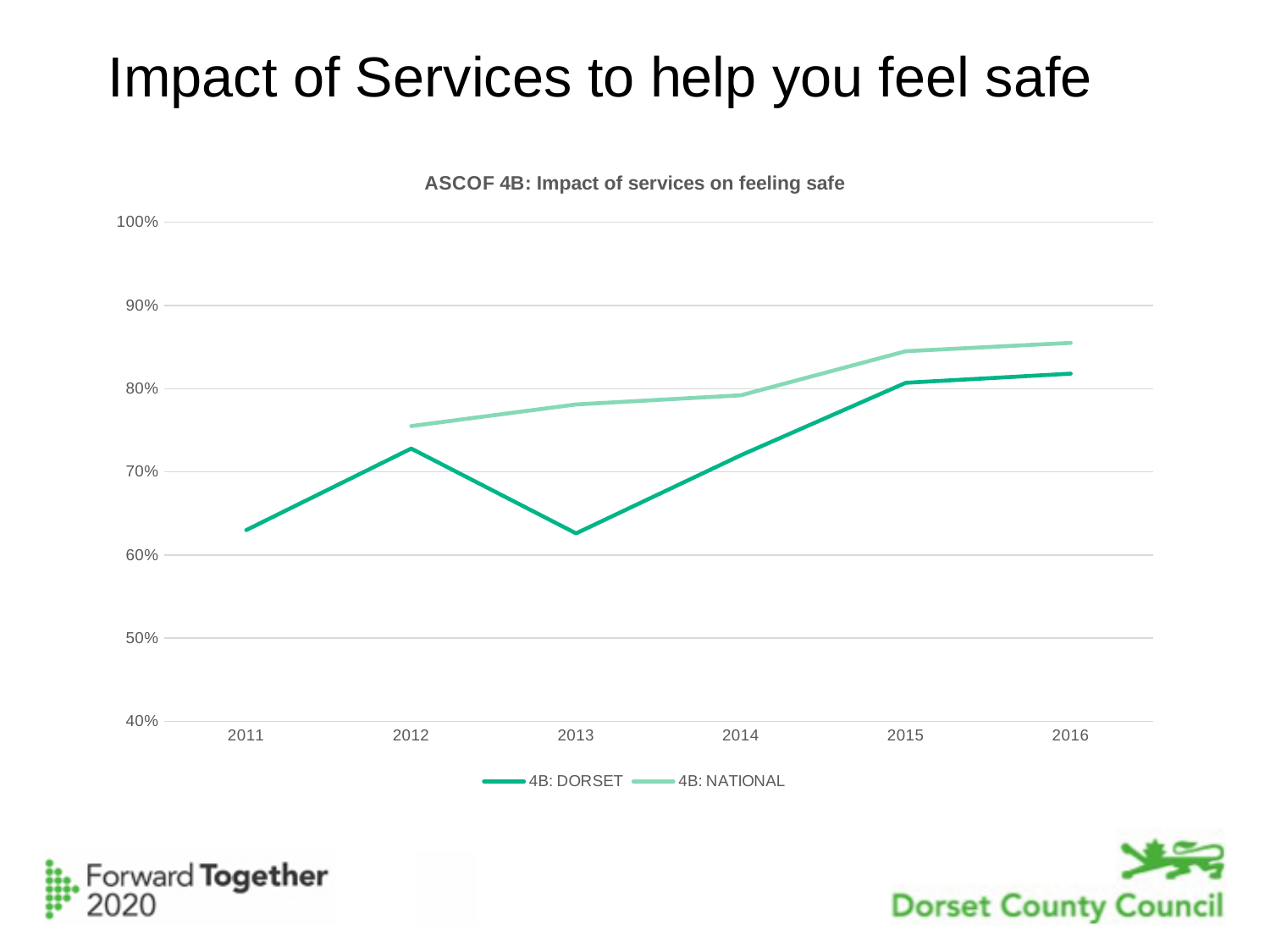
Is the 4B: DORSET value for 2016 greater or less than 80%? greater What is the title of the chart? ASCOF 4B: Impact of services on feeling safe Is the 4B: NATIONAL value for 2015 greater or less than 80%? greater How many years are shown on the x axis? 6 Which series is drawn in the lighter green line? 4B: NATIONAL How many series does the legend list? 2 Is the 4B: DORSET value for 2013 greater or less than 70%? less What kind of chart is shown on the slide? line chart In which year is the 4B: DORSET value highest? 2016 In which year is the 4B: NATIONAL value lowest? 2012 Does the 4B: NATIONAL line rise or fall from 2012 to 2016? rise In 2014, which series has the higher value, 4B: DORSET or 4B: NATIONAL? 4B: NATIONAL